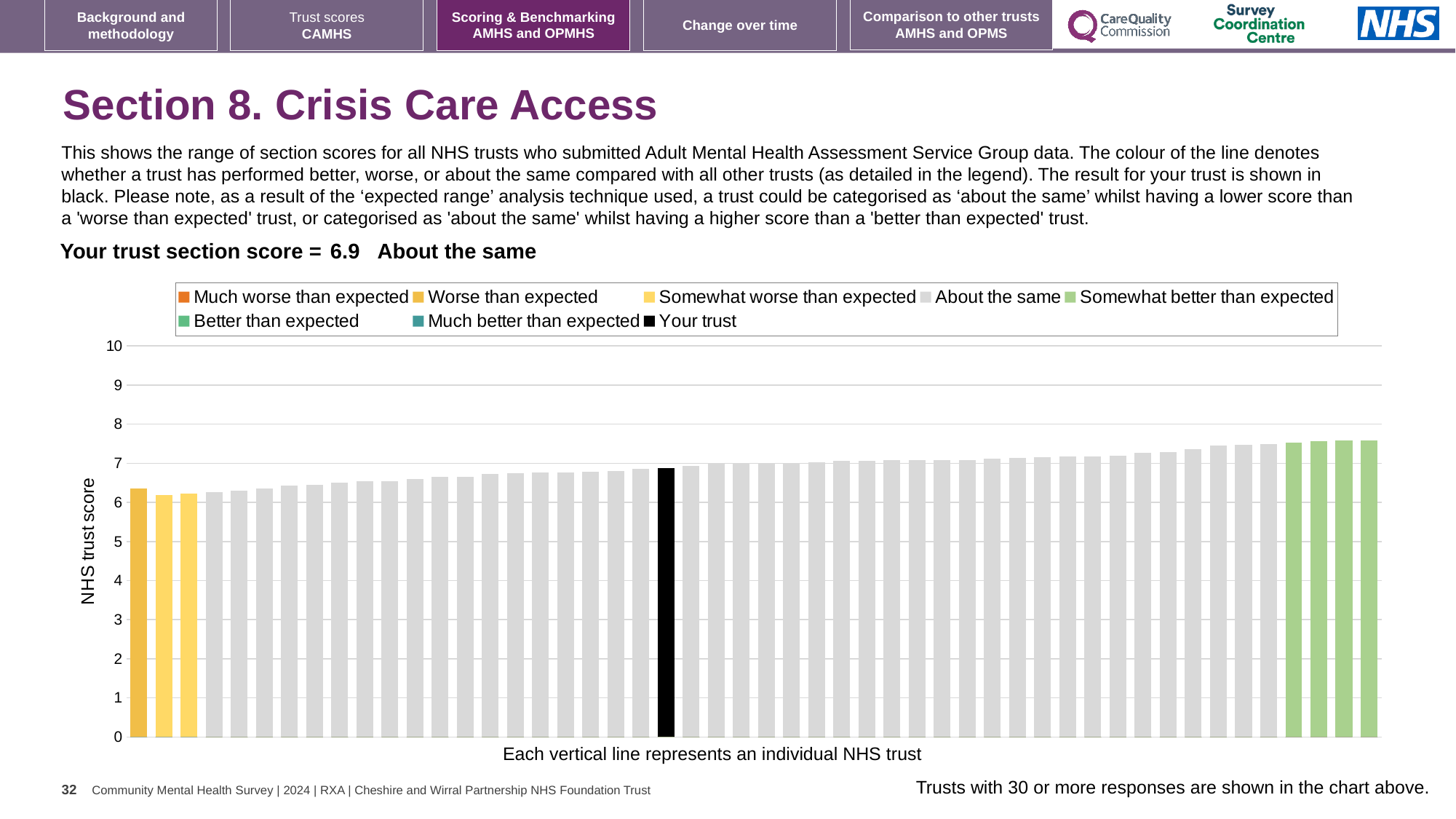
How many entries does the chart legend list? 8 How many bars are coloured green (Somewhat better than expected)? 4 Is the value of the leftmost bar greater or less than 7? less What colour is used for the 'Your trust' bar in the chart? black Which is taller: the black 'Your trust' bar or the leftmost bar? the black 'Your trust' bar Which category is your trust placed in for this section? About the same Is the value of the black 'Your trust' bar greater or less than 5? greater Is the value of the tallest bar in the chart greater or less than 8? less What is the label on the vertical axis of the chart? NHS trust score What kind of chart is shown on the slide? bar chart Do the bar values rise or fall from left to right across the chart? rise What is the section score for your trust shown on the slide? 6.9